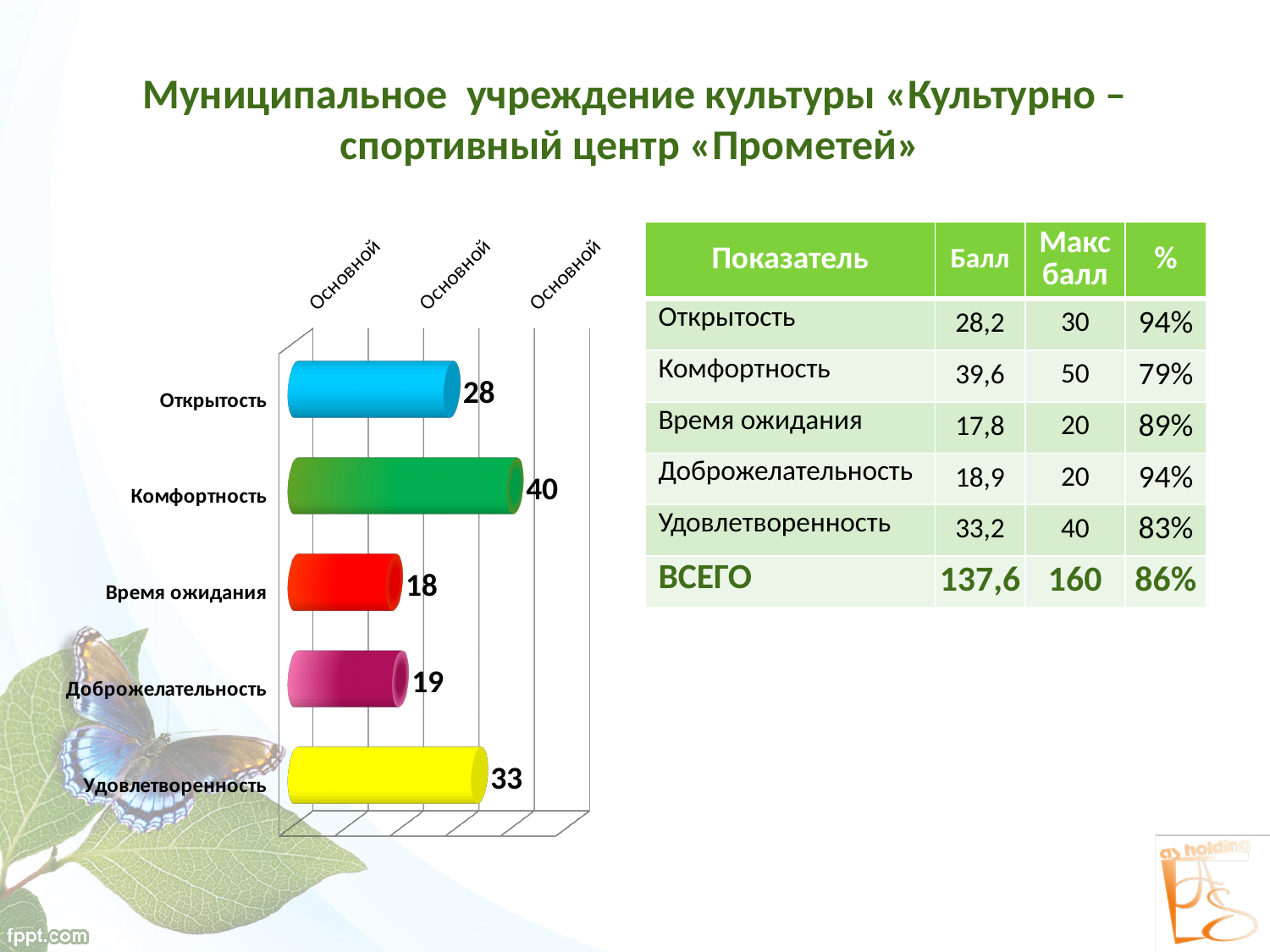
What kind of chart is shown on the slide? bar chart Which category has the highest value in the chart? Комфортность What colour is the bar for Удовлетворенность in the chart? yellow What value does the chart show for Открытость? 28 What is the difference between the values for Комфортность and Удовлетворенность in the chart? 7 What value does the chart show for Удовлетворенность? 33 What value does the chart show for Время ожидания? 18 How many categories are plotted in the chart? 5 Which category has the lowest value in the chart? Время ожидания What is the difference between the values for Открытость and Доброжелательность in the chart? 9 Which is larger in the chart, the value for Открытость or the value for Удовлетворенность? Удовлетворенность What value does the chart show for Комфортность? 40